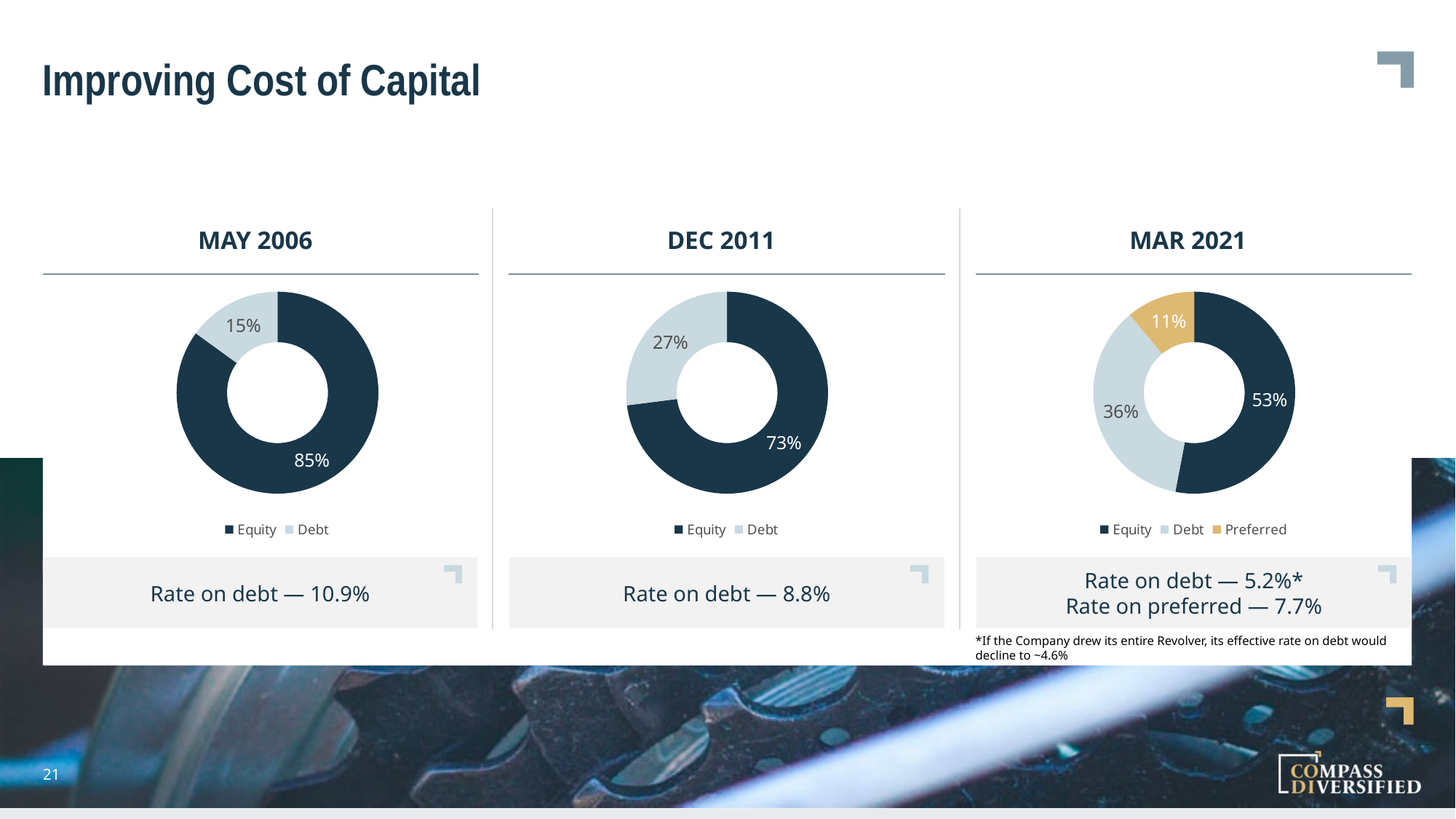
In the DEC 2011 chart, what share does Debt hold? 27% In the MAR 2021 chart, which is larger, the Debt share or the Preferred share? Debt What colour represents Preferred in the MAR 2021 chart? Gold In the MAR 2021 chart, what share does Preferred hold? 11% In the DEC 2011 chart, which category has the largest share? Equity What kind of chart is used for MAY 2006? Doughnut (pie) chart In the MAY 2006 chart, what share does Debt hold? 15% How many categories does the legend of the MAR 2021 chart list? 3 In the DEC 2011 chart, what is the difference between the Equity and Debt shares? 46 percentage points In the MAR 2021 chart, which category has the smallest share? Preferred In the MAR 2021 chart, what share does Equity hold? 53% In the MAY 2006 chart, what share does Equity hold? 85%